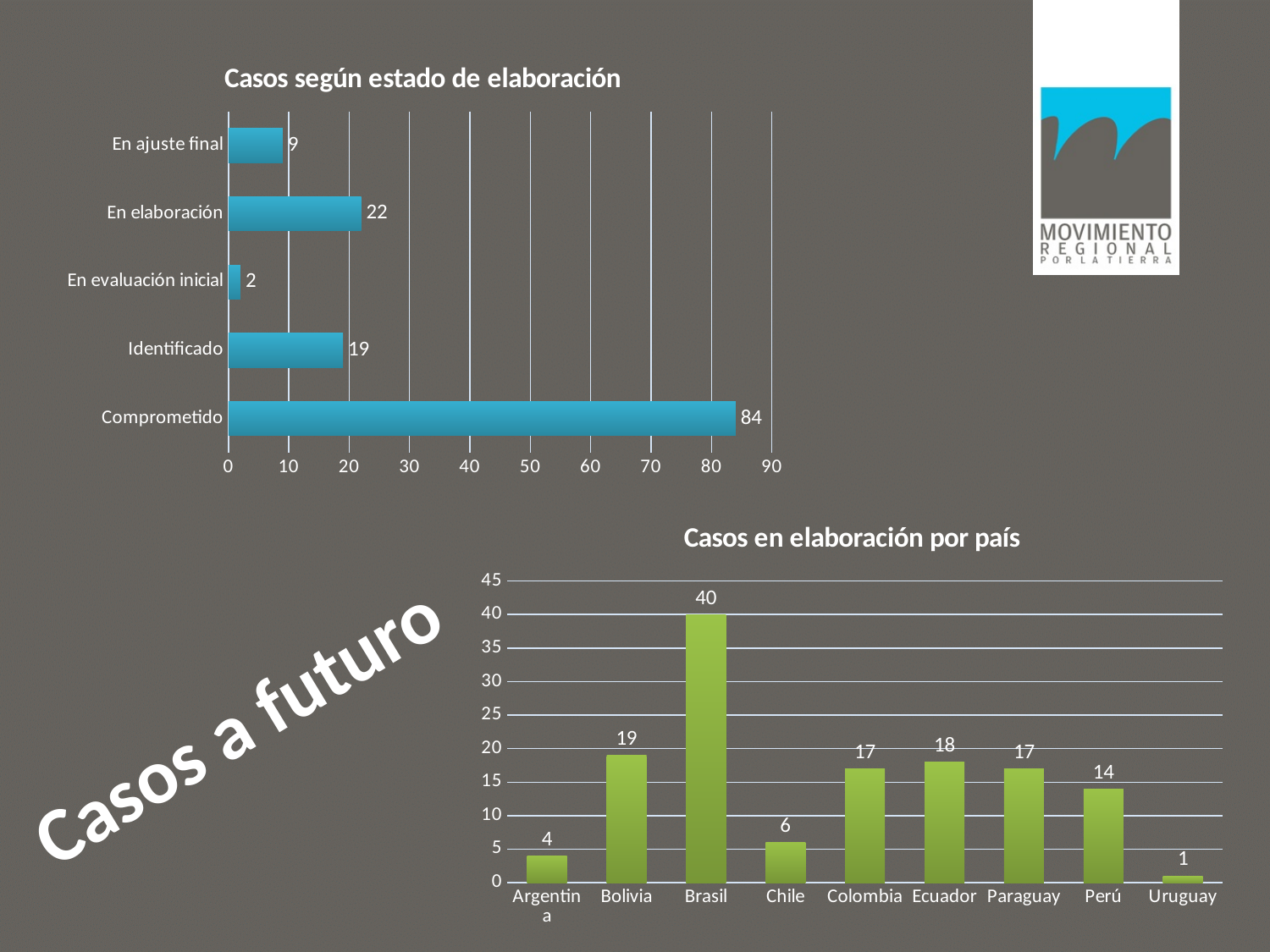
What is the title of the lower chart on the slide? Casos en elaboración por país In the 'Casos en elaboración por país' chart, which country has the lowest value? Uruguay In the 'Casos según estado de elaboración' chart, what is the value for Comprometido? 84 In the 'Casos según estado de elaboración' chart, which category has the lowest value? En evaluación inicial In the 'Casos en elaboración por país' chart, which is larger, Bolivia or Chile? Bolivia In the 'Casos en elaboración por país' chart, what is the value for Brasil? 40 In the 'Casos en elaboración por país' chart, how many countries are shown? 9 In the 'Casos según estado de elaboración' chart, how many categories are shown? 5 In the 'Casos en elaboración por país' chart, what is the difference between Brasil and Perú? 26 In the 'Casos según estado de elaboración' chart, what is the difference between En elaboración and Identificado? 3 In the 'Casos en elaboración por país' chart, which country has the highest value? Brasil What kind of chart is 'Casos según estado de elaboración'? Bar chart